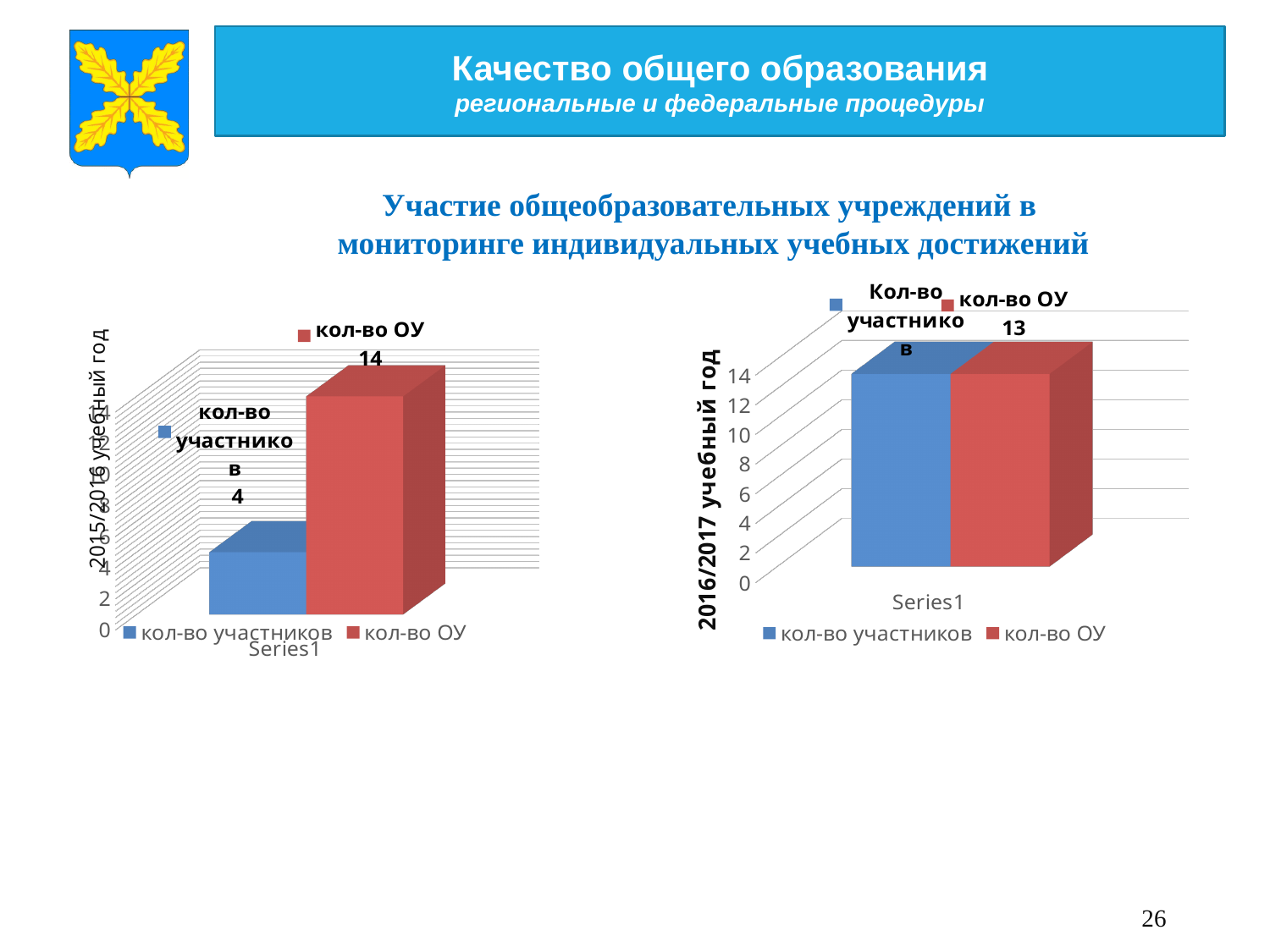
In the left chart (2015/2016 учебный год), which series has the lower value? кол-во участников In the right chart (2016/2017 учебный год), is the value for кол-во участников greater or less than 10? greater In the left chart (2015/2016 учебный год), which series has the higher value? кол-во ОУ What is the vertical axis title of the right chart? 2016/2017 учебный год In the left chart (2015/2016 учебный год), what is the difference between кол-во ОУ and кол-во участников? 10 In the left chart (2015/2016 учебный год), what colour is the bar for кол-во ОУ? red What kind of chart is the left chart (2015/2016 учебный год)? bar chart In the left chart (2015/2016 учебный год), what is the value for кол-во участников? 4 In the right chart (2016/2017 учебный год), what is the value for кол-во ОУ? 13 How many series does the legend of the right chart (2016/2017 учебный год) list? 2 In the left chart (2015/2016 учебный год), is the value for кол-во участников greater or less than 6? less In the left chart (2015/2016 учебный год), what is the value for кол-во ОУ? 14